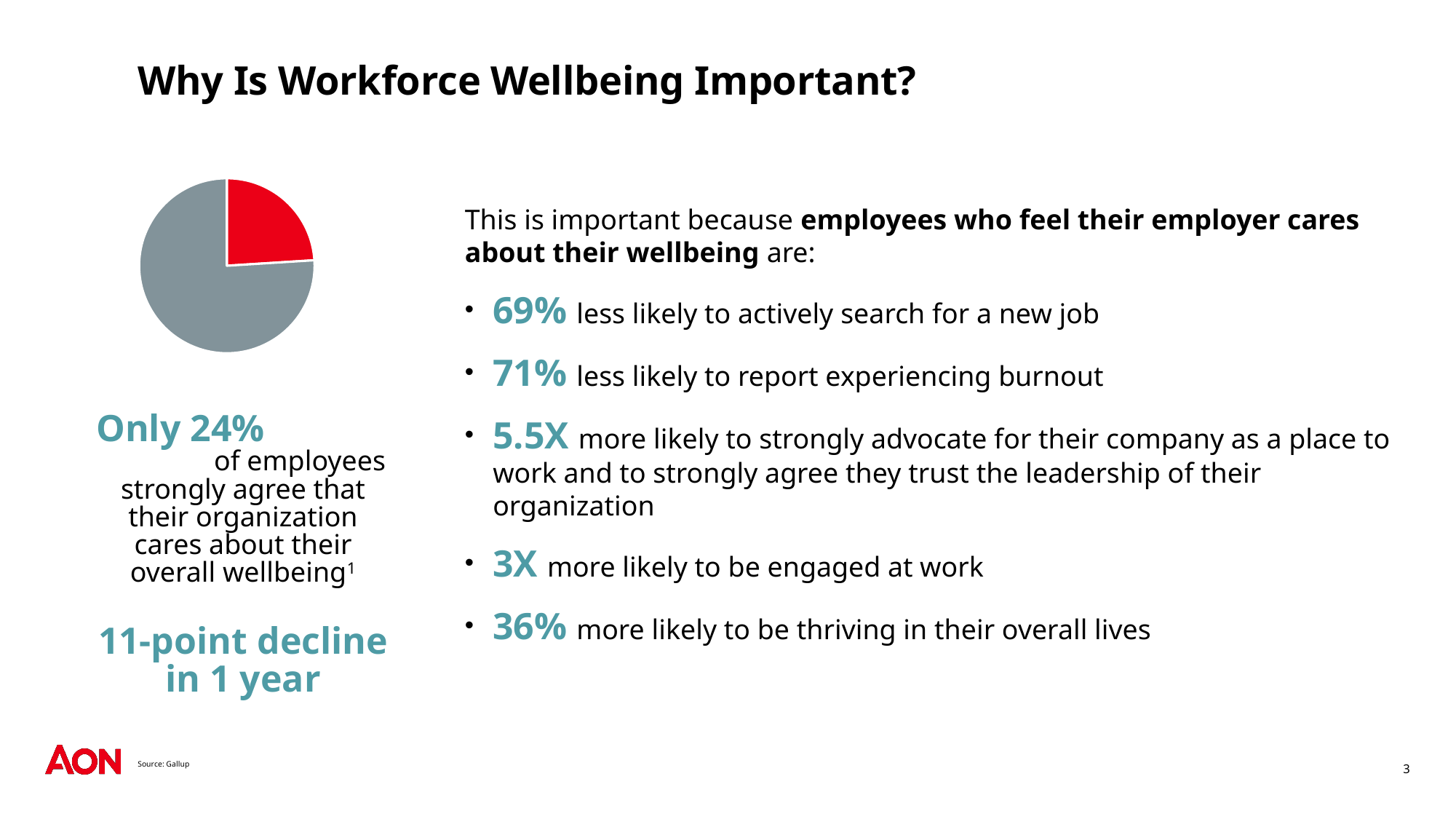
What does the pie chart's highlighted slice represent, according to the caption below it? employees who strongly agree that their organization cares about their overall wellbeing Is the grey slice of the pie chart greater or less than 50% of the pie? greater Which slice of the pie chart is larger, the grey one or the red one? grey Is the red slice of the pie chart greater or less than 50% of the pie? less What share of employees does the red slice of the pie chart represent, according to the text beneath it? 24% What kind of chart is shown on the slide? pie chart How many slices does the pie chart have? 2 What colour is the smaller slice of the pie chart? red